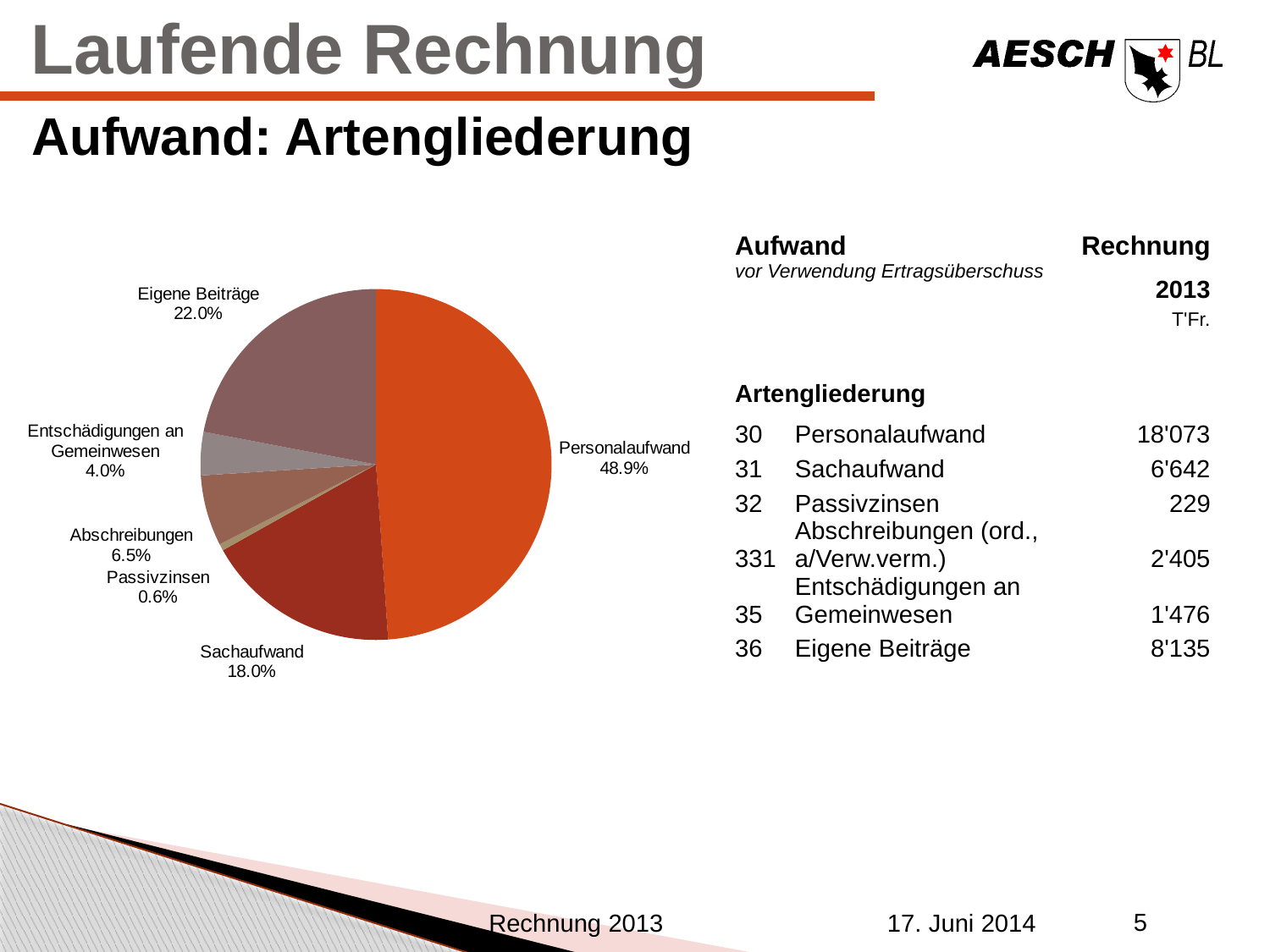
Which is larger, the share for Abschreibungen or the share for Entschädigungen an Gemeinwesen? Abschreibungen What is the difference in percentage points between Personalaufwand and Eigene Beiträge? 26.9 What kind of chart is shown on the slide? pie chart What percentage is shown for Sachaufwand? 18.0% What percentage is shown for Entschädigungen an Gemeinwesen? 4.0% Which slice of the pie is the smallest? Passivzinsen What is the difference in percentage points between Eigene Beiträge and Sachaufwand? 4.0 What percentage is shown for Eigene Beiträge? 22.0% What percentage is shown for Abschreibungen? 6.5% What share of the pie does Personalaufwand represent? 48.9% How many slices does the pie chart have? 6 Which slice of the pie is the largest? Personalaufwand